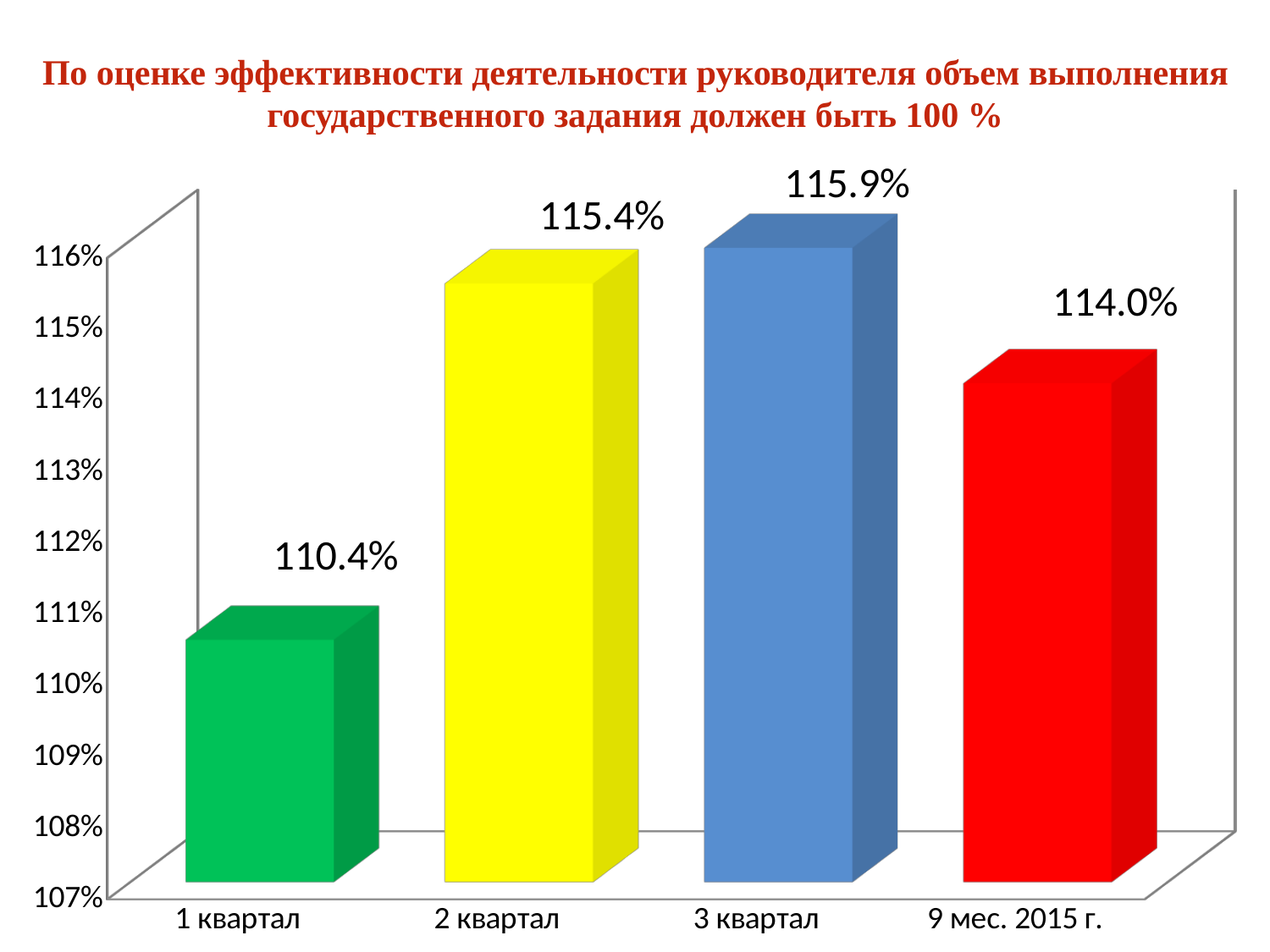
Which category has the highest value? 3 квартал Which category has the lowest value? 1 квартал What kind of chart is shown on the slide? Bar chart What is the value for 9 мес. 2015 г.? 114.0% What is the difference between the values for 3 квартал and 9 мес. 2015 г.? 1.9% What is the difference between the values for 2 квартал and 1 квартал? 5.0% What is the value for 1 квартал? 110.4% What is the value for 2 квартал? 115.4% How many categories are shown on the chart? 4 Which is larger, the value for 2 квартал or the value for 9 мес. 2015 г.? 2 квартал What is the value for 3 квартал? 115.9% What colour is the bar for 3 квартал? Blue